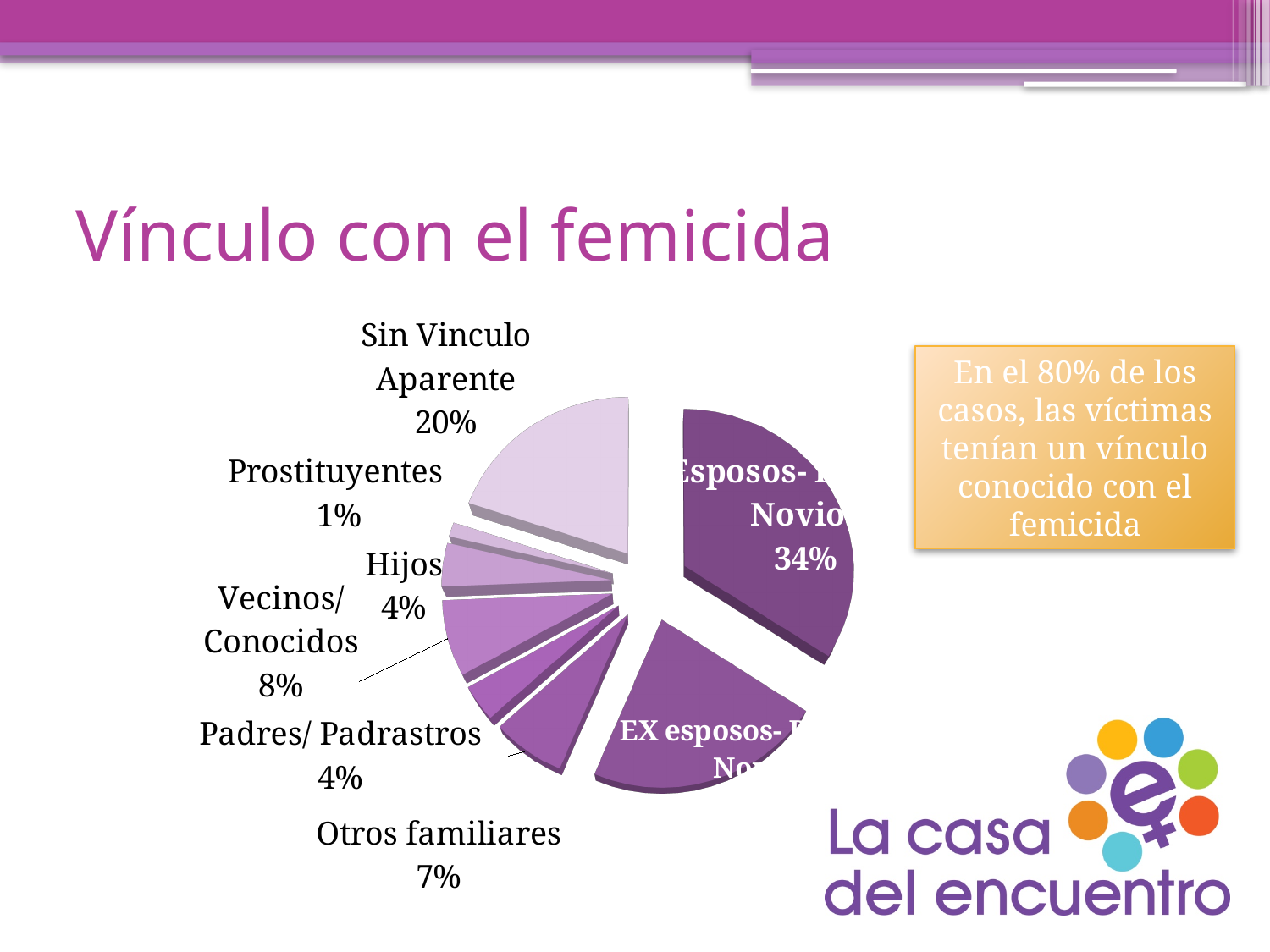
What percentage is shown for 'Hijos'? 4% What percentage is shown for 'Padres/ Padrastros'? 4% Which is larger, the share for 'Vecinos/ Conocidos' or for 'Otros familiares'? Vecinos/ Conocidos What percentage is shown for 'Otros familiares'? 7% What percentage is shown for 'Vecinos/ Conocidos'? 8% What share does the 'Prostituyentes' slice represent? 1% What is the largest percentage printed on the pie chart? 34% What is the title of the slide containing the chart? Vínculo con el femicida What type of chart is shown on the slide? Pie chart How many percentage points larger is 'Sin Vinculo Aparente' than 'Vecinos/ Conocidos'? 12% What percentage of the pie chart is labelled 'Sin Vinculo Aparente'? 20% Which category has the smallest share of the pie chart? Prostituyentes